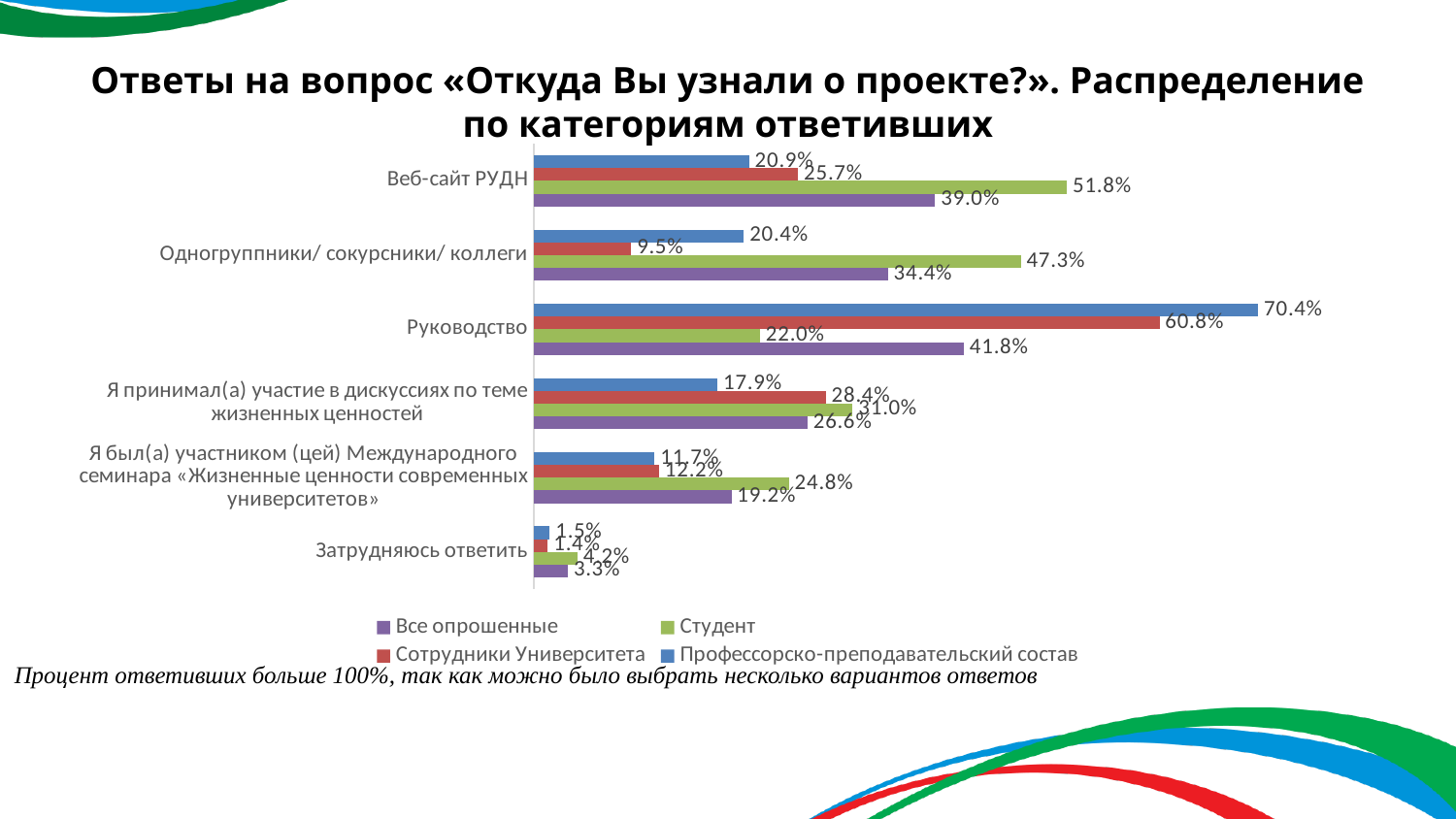
Which category has the highest value for «Все опрошенные»? Руководство In the «Одногруппники/ сокурсники/ коллеги» category, which is larger: the value for «Студент» or for «Сотрудники Университета»? Студент How many series does the legend list? 4 What is the value for «Профессорско-преподавательский состав» in the «Руководство» category? 70.4% What is the difference between the «Студент» and «Все опрошенные» values in the «Веб-сайт РУДН» category? 12.8% What type of chart is shown on the slide? bar chart Which category has the lowest value for «Студент»? Затрудняюсь ответить What is the value for «Студент» in the «Веб-сайт РУДН» category? 51.8% What is the value for «Все опрошенные» in the «Одногруппники/ сокурсники/ коллеги» category? 34.4% Which series is shown in green in the legend? Студент What is the value for «Сотрудники Университета» in the «Руководство» category? 60.8% How many answer categories are shown on the chart? 6